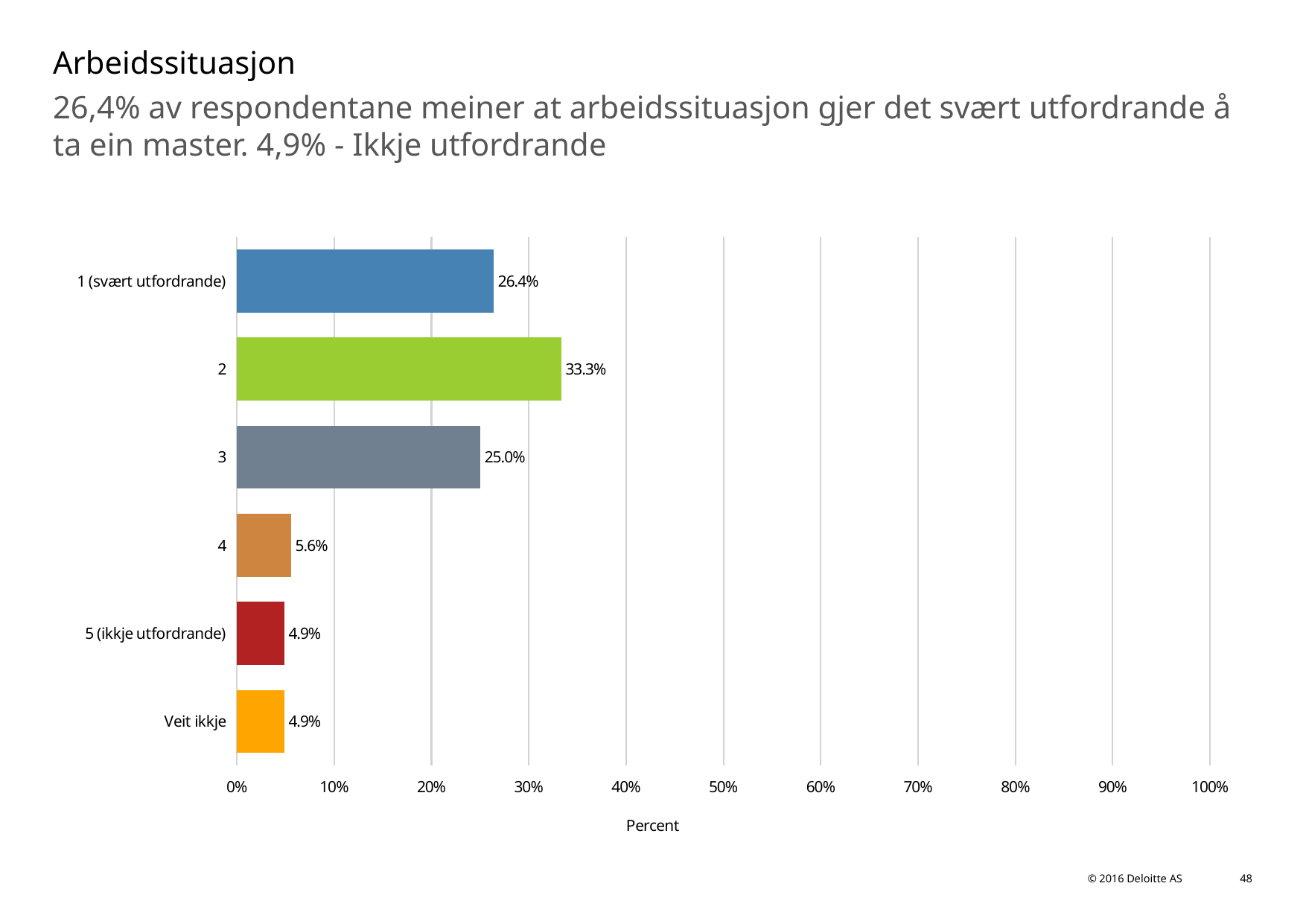
What kind of chart is shown on the slide? Bar chart What is the difference between the values for category "2" and category "3"? 8.3% Is the value for category "2" greater or less than 30%? greater What is the label of the horizontal axis? Percent What is the difference between the values for category "4" and "5 (ikkje utfordrande)"? 0.7% What is the value for category "4"? 5.6% What is the value for "Veit ikkje"? 4.9% Which is larger, the value for "1 (svært utfordrande)" or the value for "3"? 1 (svært utfordrande) How many categories are shown in the chart? 6 Which category has the highest value? 2 What is the value for the category "1 (svært utfordrande)"? 26.4% What is the value for category "2"? 33.3%